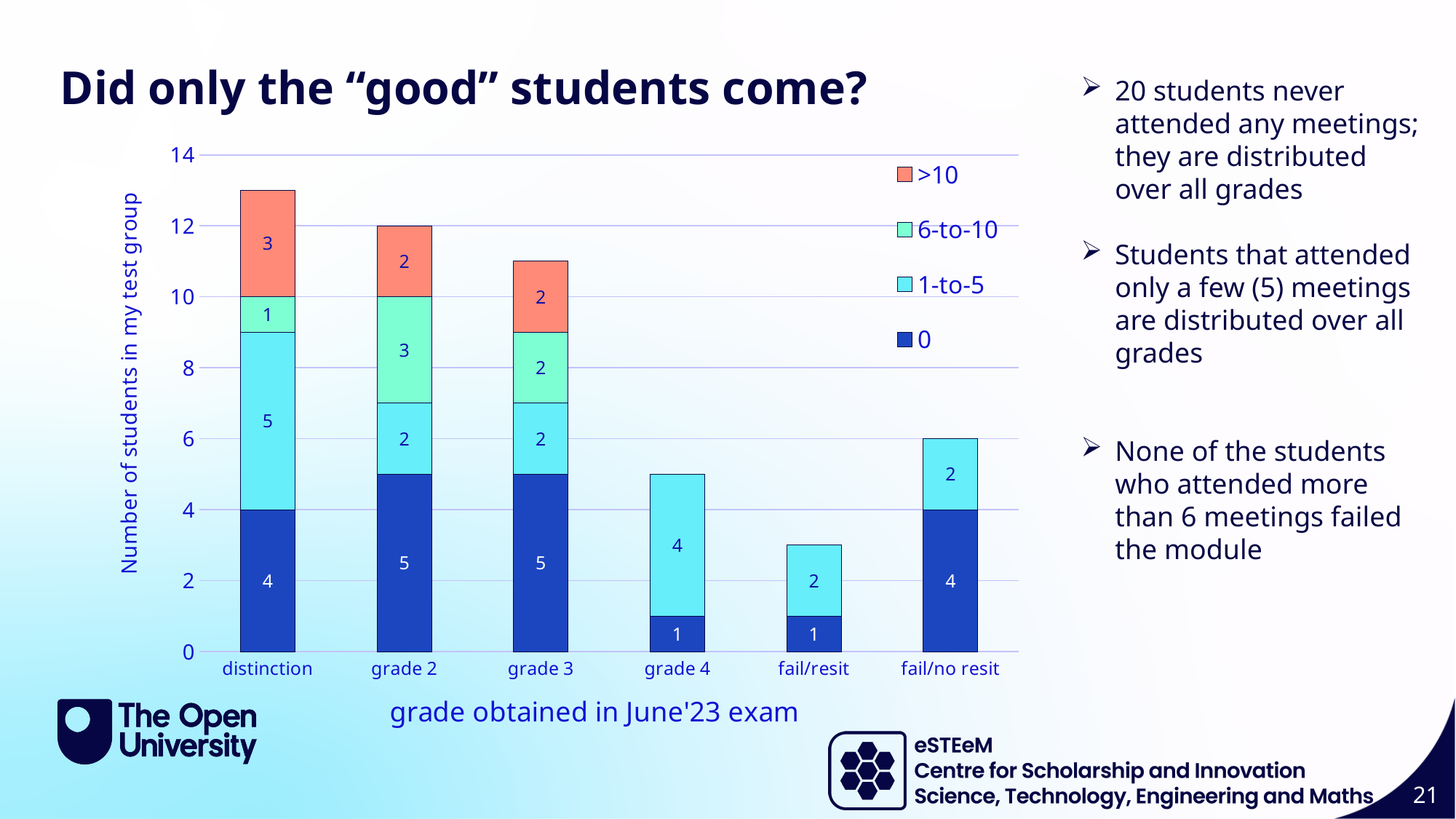
Which grade category has the shortest stacked bar? fail/resit How many students with 0 meetings attended obtained a distinction? 4 Which grade category has the tallest stacked bar? distinction How many series does the legend list? 4 How many grade categories are shown on the x axis? 6 What is the value of the 1-to-5 series for grade 4? 4 What is the total number of students in the distinction bar? 13 What is the difference between the 0-series values for grade 2 and grade 4? 4 What is the value of the >10 series for distinction? 3 What is the total number of students in the fail/resit bar? 3 What kind of chart is shown on the slide? stacked bar chart What is the value of the 6-to-10 series for grade 2? 3